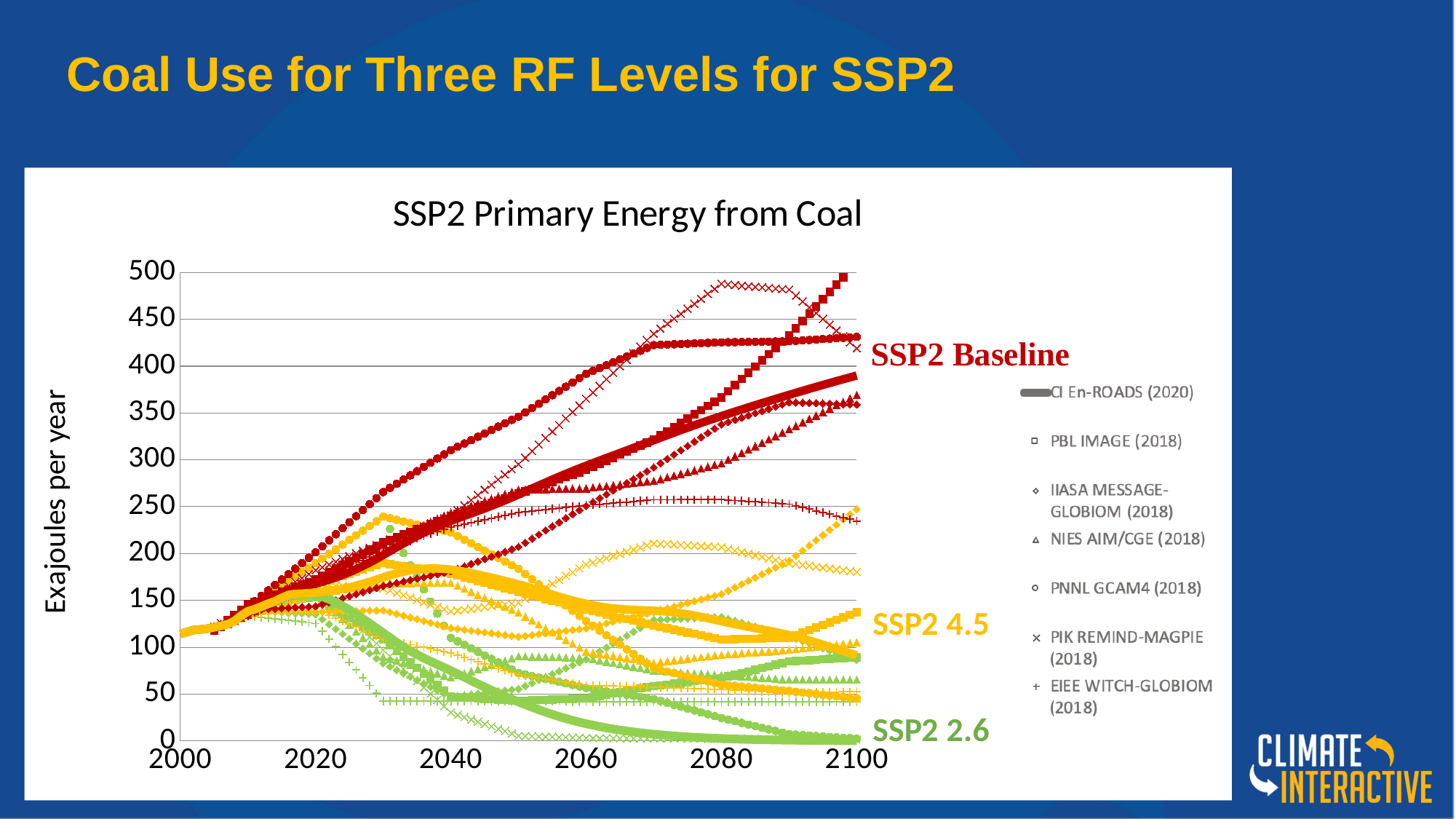
In 2100, which is larger: the thick CI En-ROADS line for SSP2 Baseline or for SSP2 2.6? SSP2 Baseline Which scenario group has the highest coal use values in 2100: SSP2 Baseline, SSP2 4.5 or SSP2 2.6? SSP2 Baseline How many model sources does the legend list? 7 What is the label on the y axis of the chart? Exajoules per year How many RF scenario groups (SSP2 Baseline, SSP2 4.5, SSP2 2.6) are plotted on the chart? 3 Is the value of the thick SSP2 Baseline CI En-ROADS line in 2100 greater or less than 350? greater Which scenario group has the lowest coal use values in 2100: SSP2 Baseline, SSP2 4.5 or SSP2 2.6? SSP2 2.6 Do the SSP2 2.6 lines rise or fall between 2020 and 2100? fall What kind of chart is shown on the slide? Line chart Is the value of the thick SSP2 2.6 CI En-ROADS line in 2100 greater or less than 50? less What is the title of the chart? SSP2 Primary Energy from Coal